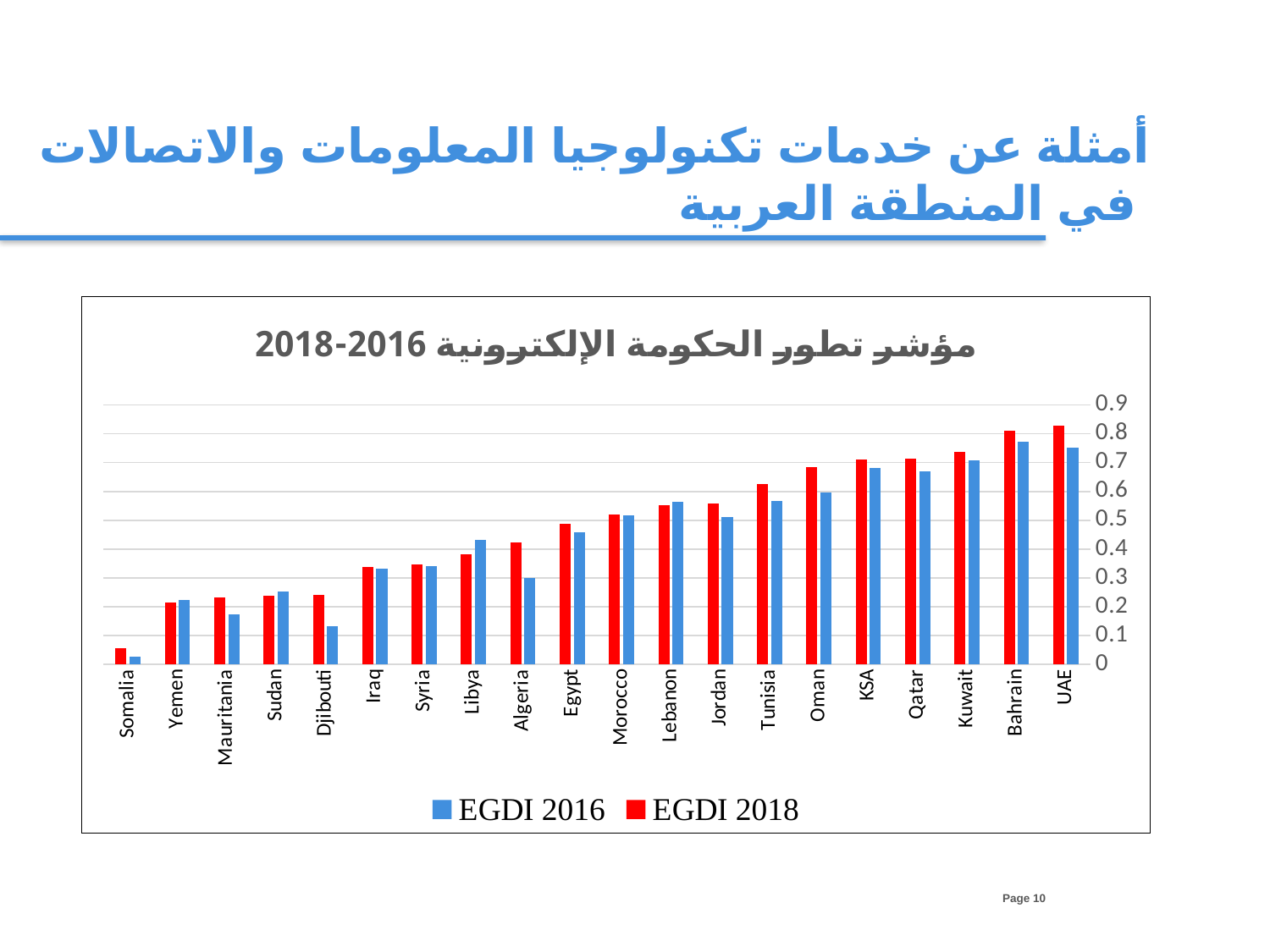
Is the EGDI 2018 value for Somalia greater or less than 0.1? less Which colour represents the EGDI 2018 series in the chart? red What kind of chart is shown on the slide? bar chart How many countries are shown on the x axis of the chart? 20 Do the EGDI 2018 values generally rise or fall moving from Somalia on the left to UAE on the right? rise For Algeria, which is larger: the EGDI 2016 value or the EGDI 2018 value? EGDI 2018 How many series does the chart's legend list? 2 Which country has the lowest EGDI 2018 value? Somalia Is the EGDI 2016 value for Djibouti greater or less than 0.2? less Which country has the lowest EGDI 2016 value? Somalia Is the EGDI 2018 value for Iraq greater or less than 0.3? greater